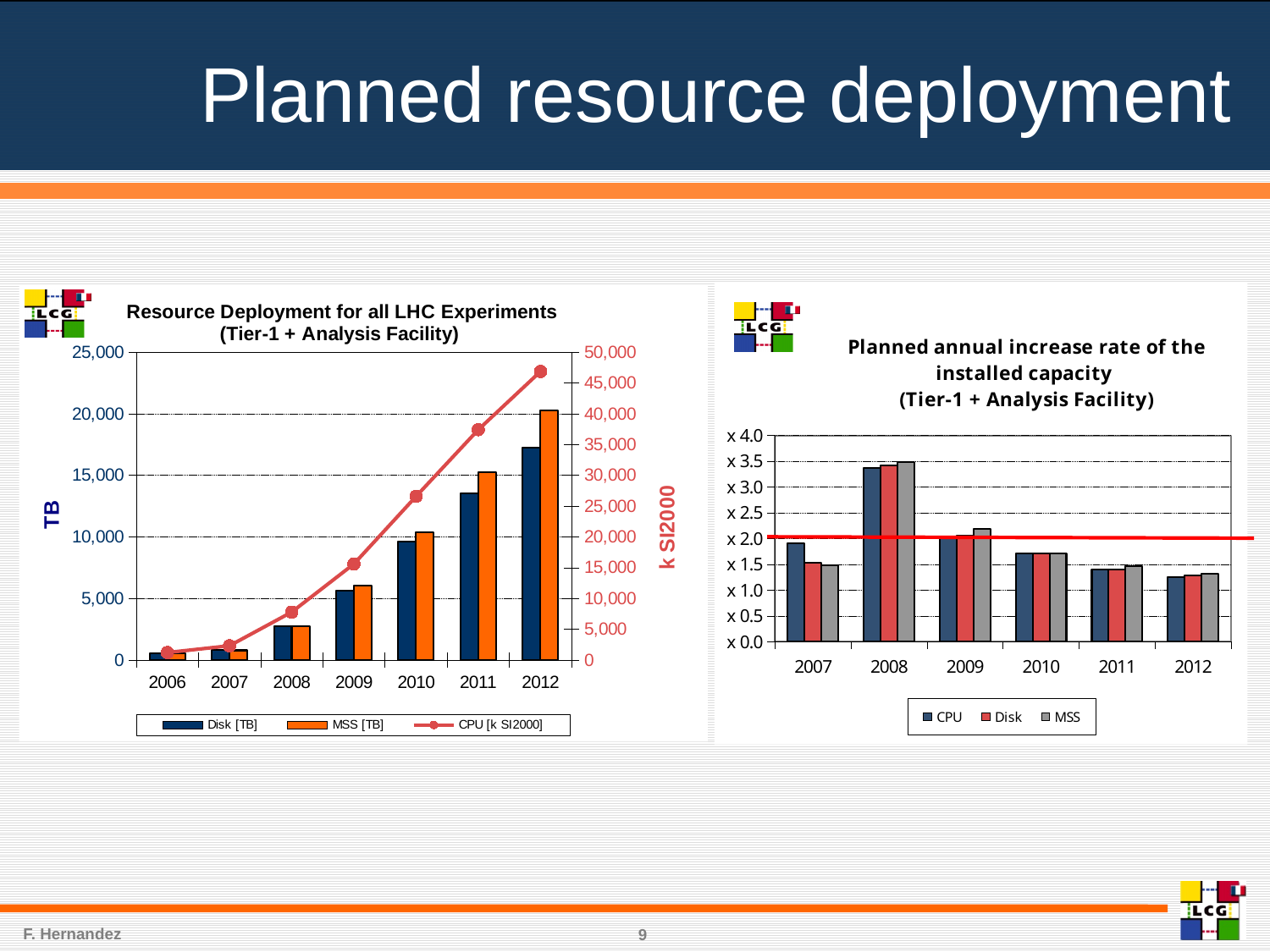
In the left chart, does the CPU [k SI2000] line rise or fall from 2006 to 2012? Rises What kind of chart is the 'Planned annual increase rate of the installed capacity' chart on the right? Bar chart In the right chart, which year has the highest increase rate for CPU? 2008 In the left chart, how many years are shown on the x axis? 7 In the right chart, which is larger, the MSS increase rate for 2008 or for 2011? 2008 In the right chart, is the CPU increase rate for 2007 greater or less than x 2.0? less How many series does the legend of the left chart list? 3 How many series does the legend of the right chart list? 3 What kind of chart is the 'Resource Deployment for all LHC Experiments' chart on the left? Combined bar and line chart In the left chart, is the CPU [k SI2000] value for 2008 greater or less than 10,000? less In the left chart, is the Disk [TB] value for 2012 greater or less than 15,000? greater In the right chart, how many years are shown on the x axis? 6